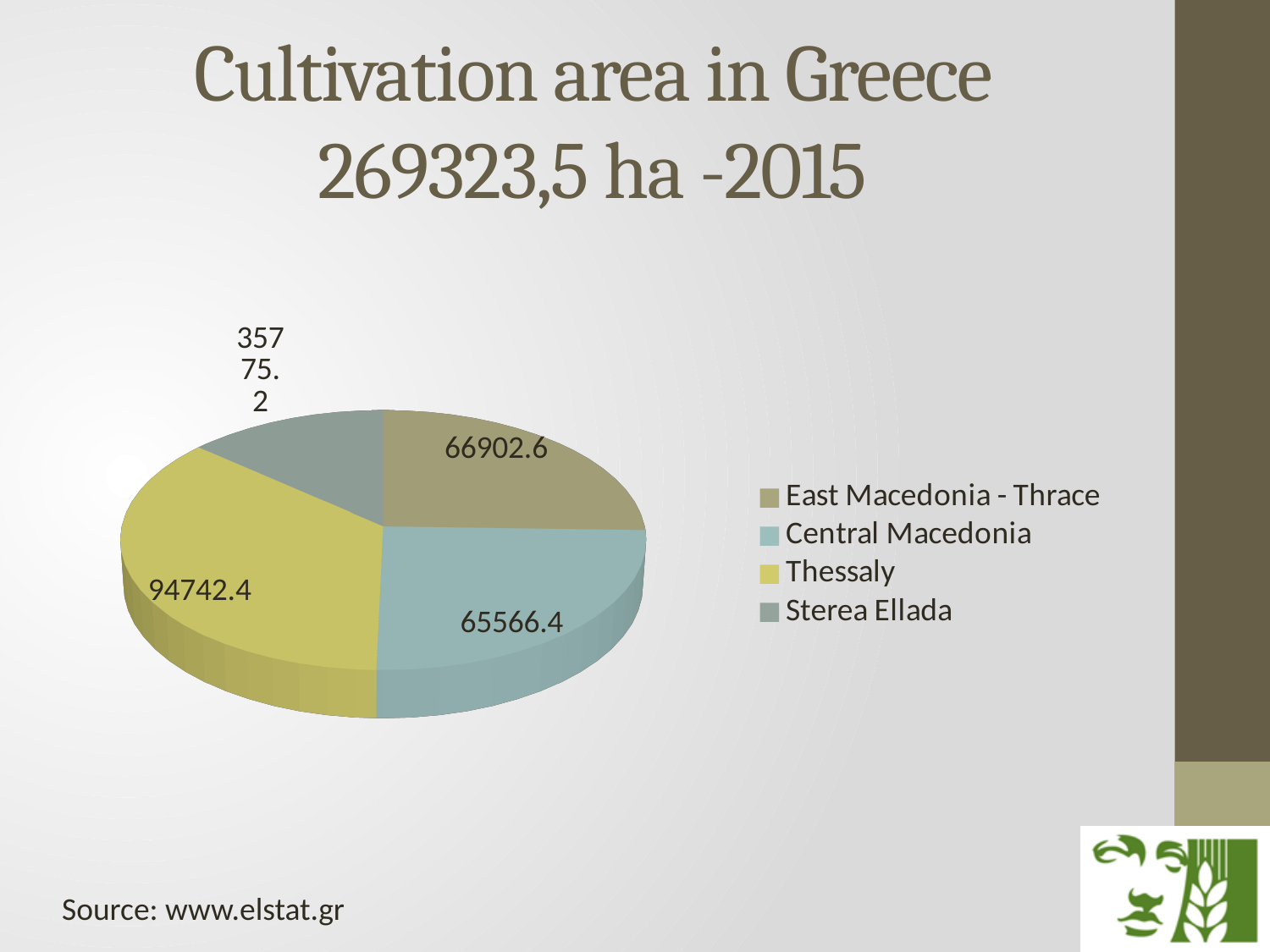
Which region has the smallest slice of the pie? Sterea Ellada What is the difference between the values for East Macedonia - Thrace and Central Macedonia? 1336.2 What is the value shown for Sterea Ellada? 35775.2 Which region has the largest slice of the pie? Thessaly How many regions are shown in the pie chart? 4 What is the value shown for East Macedonia - Thrace? 66902.6 What is the difference between the values for Thessaly and East Macedonia - Thrace? 27839.8 What is the title of the chart slide? Cultivation area in Greece 269323,5 ha -2015 What type of chart is shown on the slide? Pie chart What is the value shown for Central Macedonia? 65566.4 Which has the larger value, East Macedonia - Thrace or Central Macedonia? East Macedonia - Thrace What is the value shown for Thessaly? 94742.4